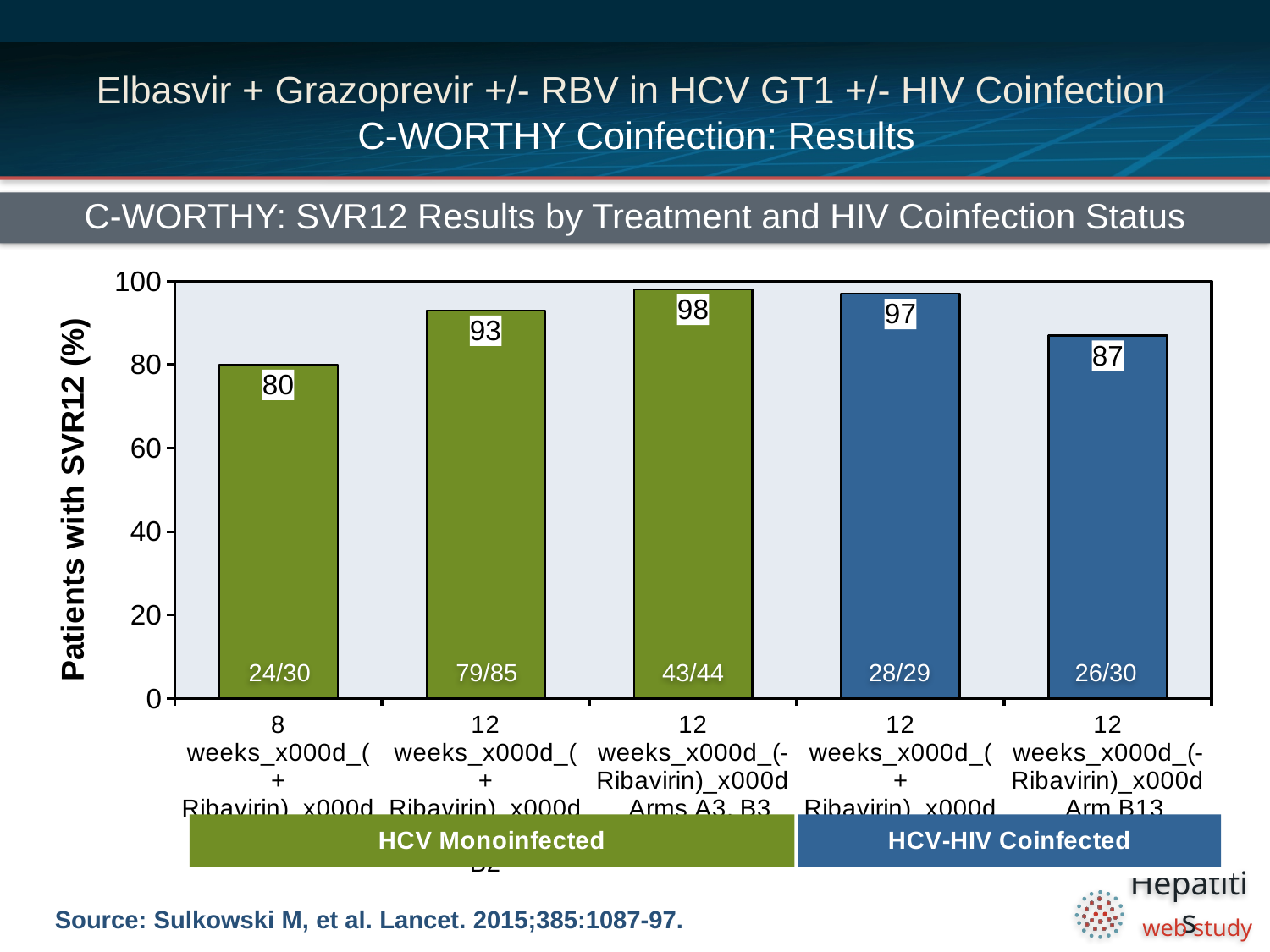
What is the SVR12 value for the 12-week (+ Ribavirin) bar in the HCV-HIV coinfected group? 97 What is the difference in SVR12 between the 12-week (- Ribavirin) Arms A3, B3 bar and the 8-week (+ Ribavirin) bar? 18 What type of chart is shown on the slide? bar chart Which bar has the lowest SVR12 value? 8 weeks (+ Ribavirin) (HCV Monoinfected) Is the SVR12 value for the 8-week (+ Ribavirin) bar greater or less than 60? greater Which bar has the highest SVR12 value? 12 weeks (- Ribavirin) Arms A3, B3 (HCV Monoinfected) What is the SVR12 value for the 8-week (+ Ribavirin) HCV monoinfected bar? 80 What is the SVR12 value for the 12-week (- Ribavirin) Arm B13 bar in the HCV-HIV coinfected group? 87 Which is larger: the SVR12 for the 12-week (+ Ribavirin) monoinfected bar or the 12-week (- Ribavirin) Arm B13 coinfected bar? 12 weeks (+ Ribavirin) monoinfected (93) What is the label of the y-axis? Patients with SVR12 (%) What fraction of patients is shown inside the 12-week (- Ribavirin) Arms A3, B3 bar? 43/44 How many bars are plotted in the chart? 5